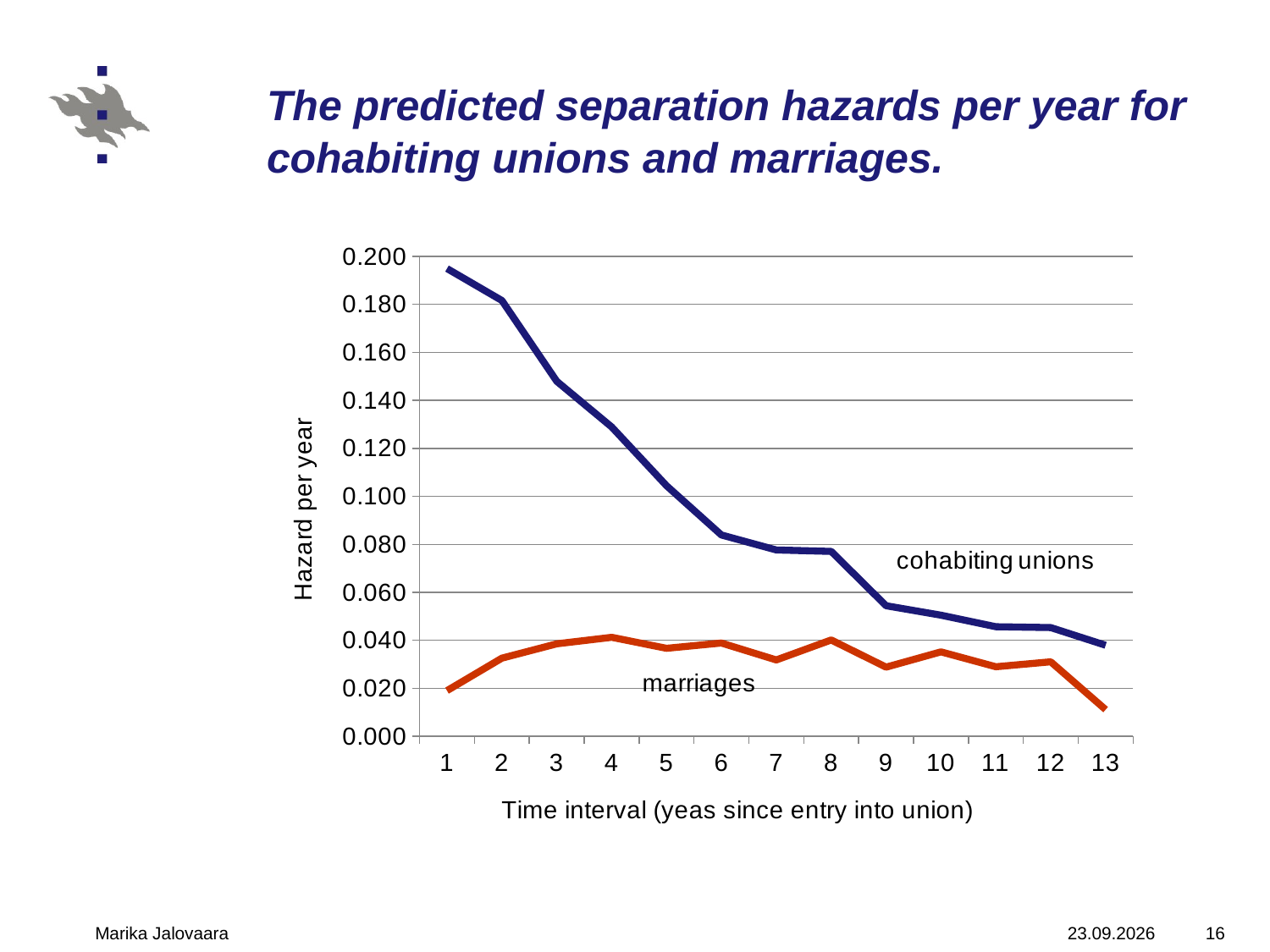
How many time intervals are plotted along the x axis? 13 Is the hazard for cohabiting unions at time interval 9 greater or less than 0.060? less How many series are plotted in the chart? 2 At which time interval is the hazard for cohabiting unions lowest? 13 What is the label of the y axis? Hazard per year Does the hazard for cohabiting unions rise or fall as the time interval increases? fall At which time interval is the hazard for marriages lowest? 13 Is the hazard for cohabiting unions at time interval 1 greater or less than 0.180? greater What kind of chart is shown on the slide? line chart At which time interval is the hazard for cohabiting unions highest? 1 Is the hazard for marriages at time interval 4 greater or less than 0.060? less Which series has the higher hazard at time interval 1, cohabiting unions or marriages? cohabiting unions